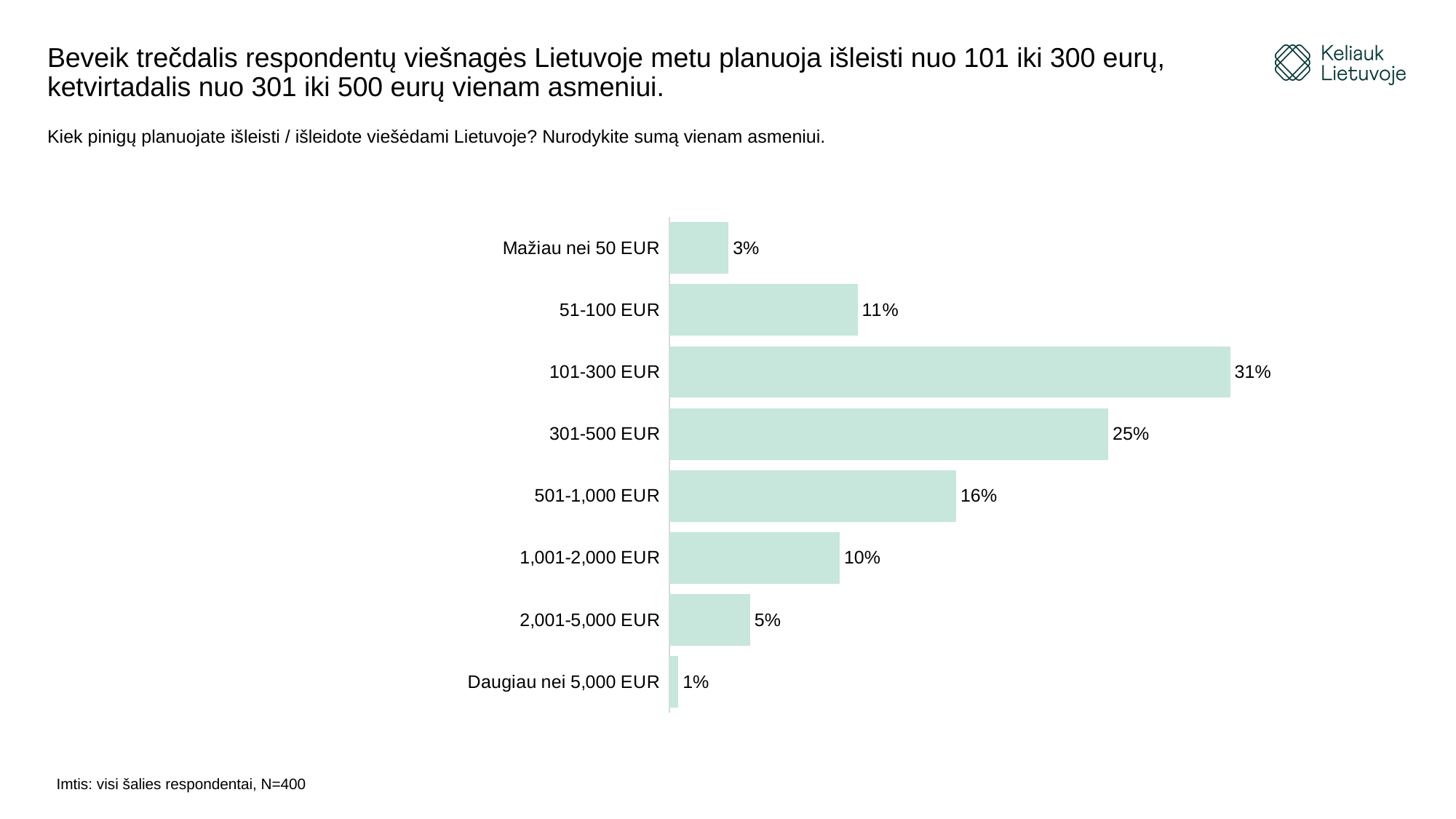
What is the value for the 301-500 EUR category? 25% How many categories are shown in the chart? 8 What kind of chart is shown on the slide? Bar chart What sample size is stated at the bottom of the slide? N=400 Which is larger: the value for 51-100 EUR or the value for 501-1,000 EUR? 501-1,000 EUR What percentage of respondents plan to spend 101-300 EUR? 31% Which category has the lowest value? Daugiau nei 5,000 EUR Which category has the highest value? 101-300 EUR What is the combined value of the 2,001-5,000 EUR and Daugiau nei 5,000 EUR categories? 6% What is the value for 1,001-2,000 EUR? 10% What is the difference between the values for 101-300 EUR and 301-500 EUR? 6% What percentage is shown for 'Mažiau nei 50 EUR'? 3%